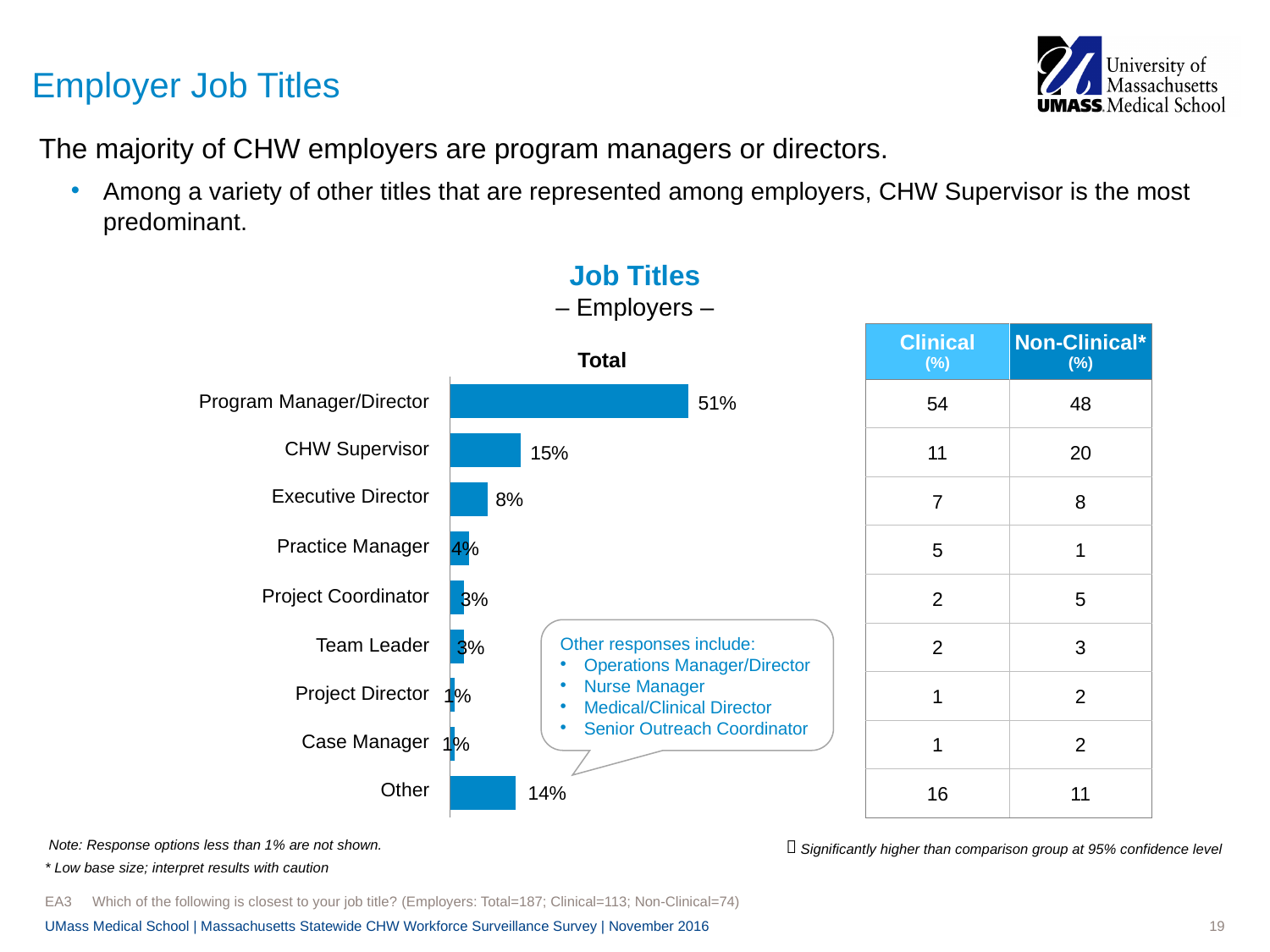
What kind of chart is the Job Titles chart? Bar chart What is the Total value for Program Manager/Director in the Job Titles chart? 51% What is the difference between the Total values for CHW Supervisor and Other in the Job Titles chart? 1% What is the Total value for Project Coordinator in the Job Titles chart? 3% What is the Total value for Other in the Job Titles chart? 14% What is the Total value for CHW Supervisor in the Job Titles chart? 15% How many job title categories are shown in the Job Titles chart? 9 In the Job Titles chart, which has a larger Total value, Other or Executive Director? Other Which job title has the highest Total value in the Job Titles chart? Program Manager/Director What is the Total value for Executive Director in the Job Titles chart? 8% What is the difference between the Total values for Program Manager/Director and CHW Supervisor in the Job Titles chart? 36% In the Job Titles chart, which has a larger Total value, Executive Director or Practice Manager? Executive Director